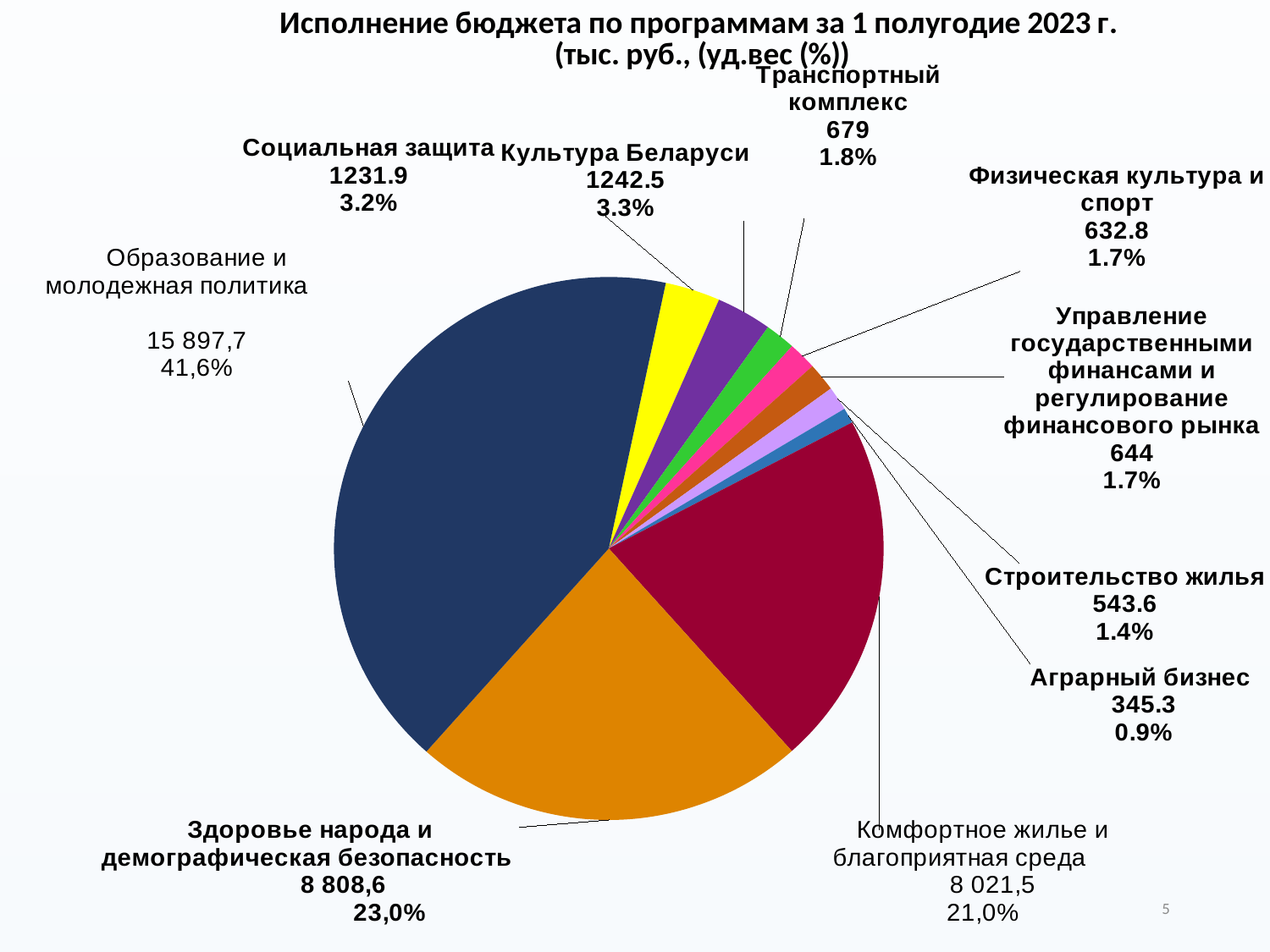
What is the difference between the values for Культура Беларуси and Социальная защита? 10.6 Which program has the largest slice of the pie? Образование и молодежная политика What share of the pie does Строительство жилья have? 1.4% What kind of chart is shown on the slide? Pie chart What share of the pie does Комфортное жилье и благоприятная среда have? 21,0% What is the value (тыс. руб.) for Образование и молодежная политика? 15 897,7 Which program has the smallest slice of the pie? Аграрный бизнес How many programs (slices) are shown in the pie chart? 10 Which is larger: the value for Здоровье народа и демографическая безопасность or for Комфортное жилье и благоприятная среда? Здоровье народа и демографическая безопасность What is the value (тыс. руб.) for Здоровье народа и демографическая безопасность? 8 808,6 What is the value (тыс. руб.) for Транспортный комплекс? 679 What is the difference between the values for Управление государственными финансами и регулирование финансового рынка and Строительство жилья? 100.4